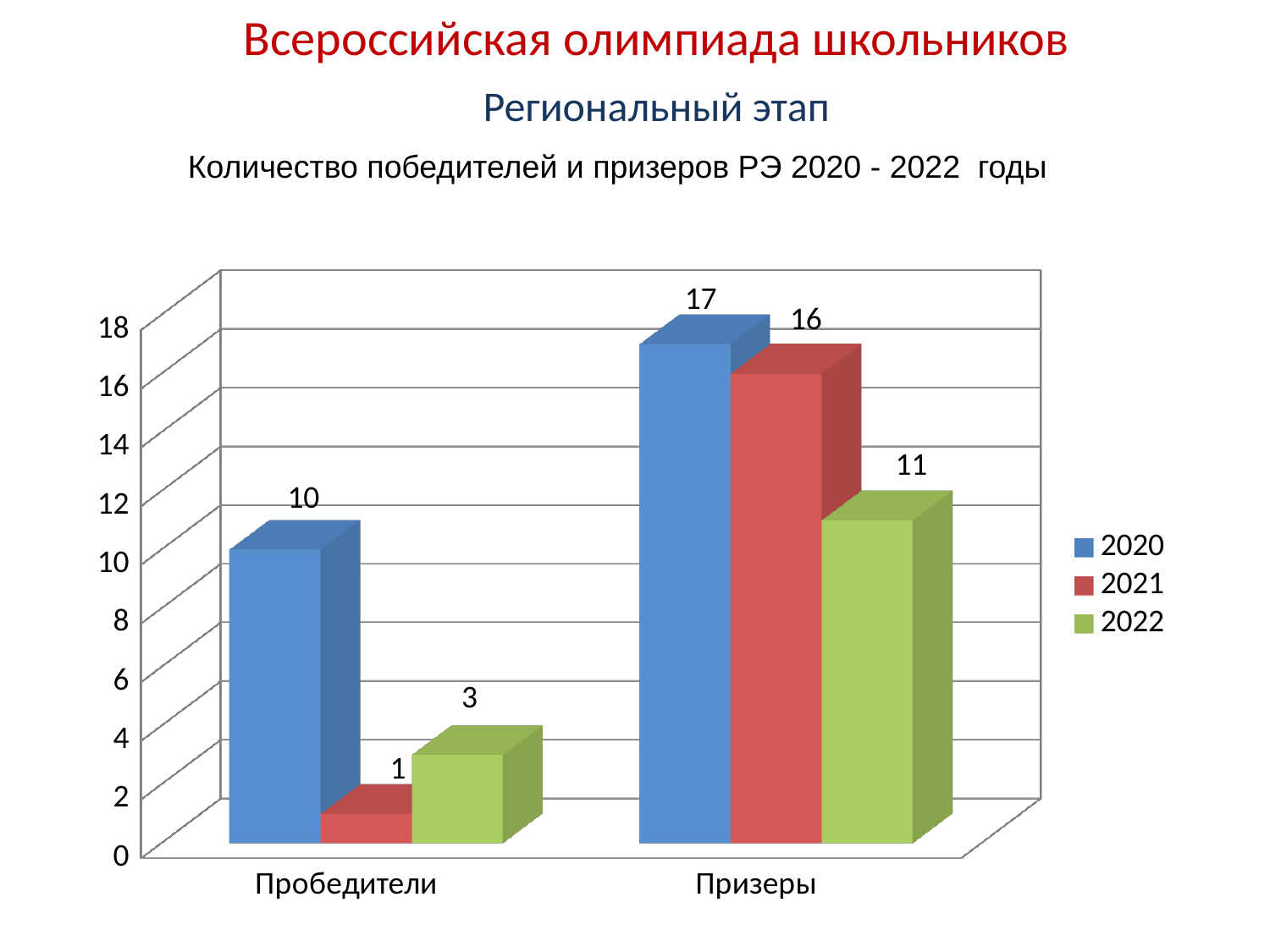
How many series does the legend list? 3 Which is larger: the 2021 value for Пробедители or the 2022 value for Пробедители? 2022 What is the value for 2020 in the Пробедители category? 10 Is the value for 2020 in the Призеры category greater or less than 14? greater Which year has the highest value in the Призеры category? 2020 How many categories are shown on the x axis? 2 What is the title of the chart? Количество победителей и призеров РЭ 2020 - 2022 годы Which year has the lowest value in the Пробедители category? 2021 What is the difference between the 2020 and 2022 values in the Призеры category? 6 What is the value for 2022 in the Пробедители category? 3 What is the value for 2021 in the Призеры category? 16 What kind of chart is shown on the slide? bar chart